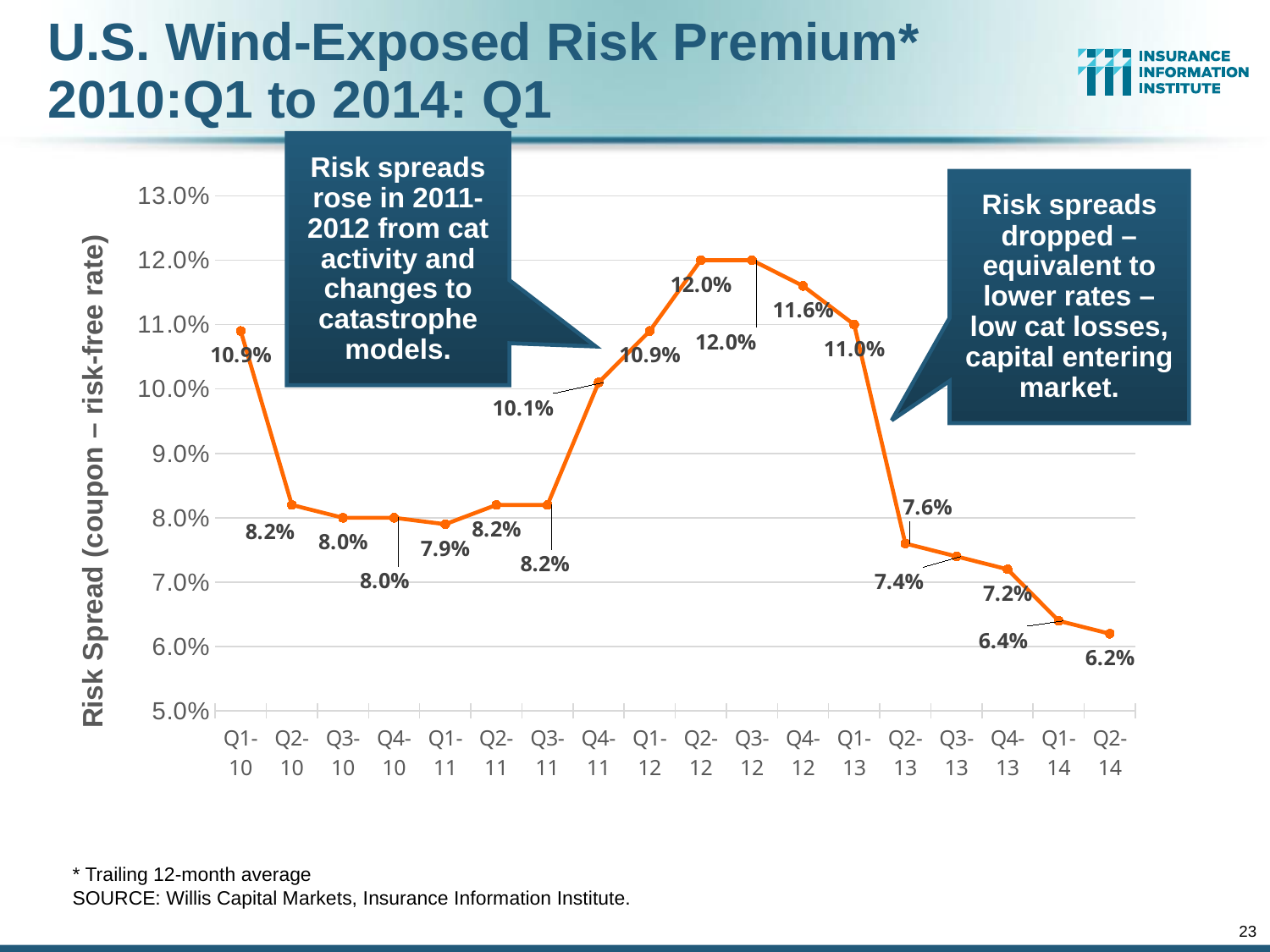
What is the value for Q1-10? 10.9% What kind of chart is shown on the slide? Line chart What is the value for Q1-13? 11.0% What is the difference between the values for Q1-13 and Q2-13? 3.4% Which is larger, the value for Q4-12 or the value for Q1-12? Q4-12 Which quarter has the lowest risk spread? Q2-14 What is the value for Q4-11? 10.1% Do the values rise or fall from Q1-13 to Q2-14? Fall What is the value for Q2-14? 6.2% What is the label of the y-axis? Risk Spread (coupon – risk-free rate) How many data points are plotted on the chart? 18 What is the highest value plotted on the chart? 12.0%